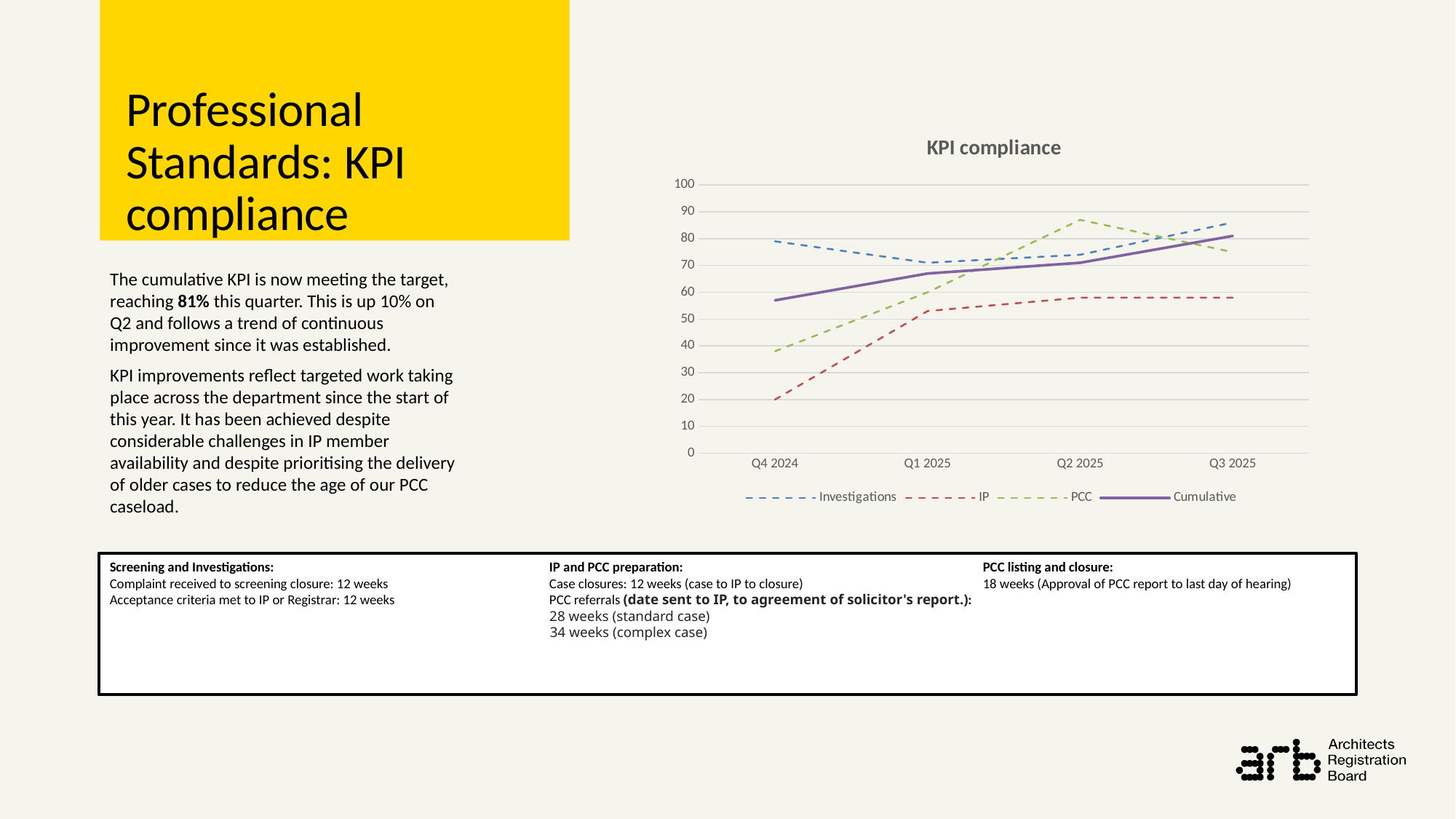
What kind of chart is shown on the slide? Line chart Which series has the highest value in Q2 2025? PCC In Q3 2025, which is larger: Investigations or IP? Investigations Is the value for Cumulative in Q3 2025 greater or less than 70? greater How many quarters are shown on the x axis of the KPI compliance chart? 4 How many series does the legend of the KPI compliance chart list? 4 Is the value for PCC in Q2 2025 greater or less than 80? greater In Q4 2024, which is larger: Investigations or PCC? Investigations Does the Cumulative series rise or fall from Q4 2024 to Q3 2025? Rises Is the value for IP in Q4 2024 greater or less than 30? less Which series has the lowest value in Q4 2024? IP What is the title of the chart? KPI compliance